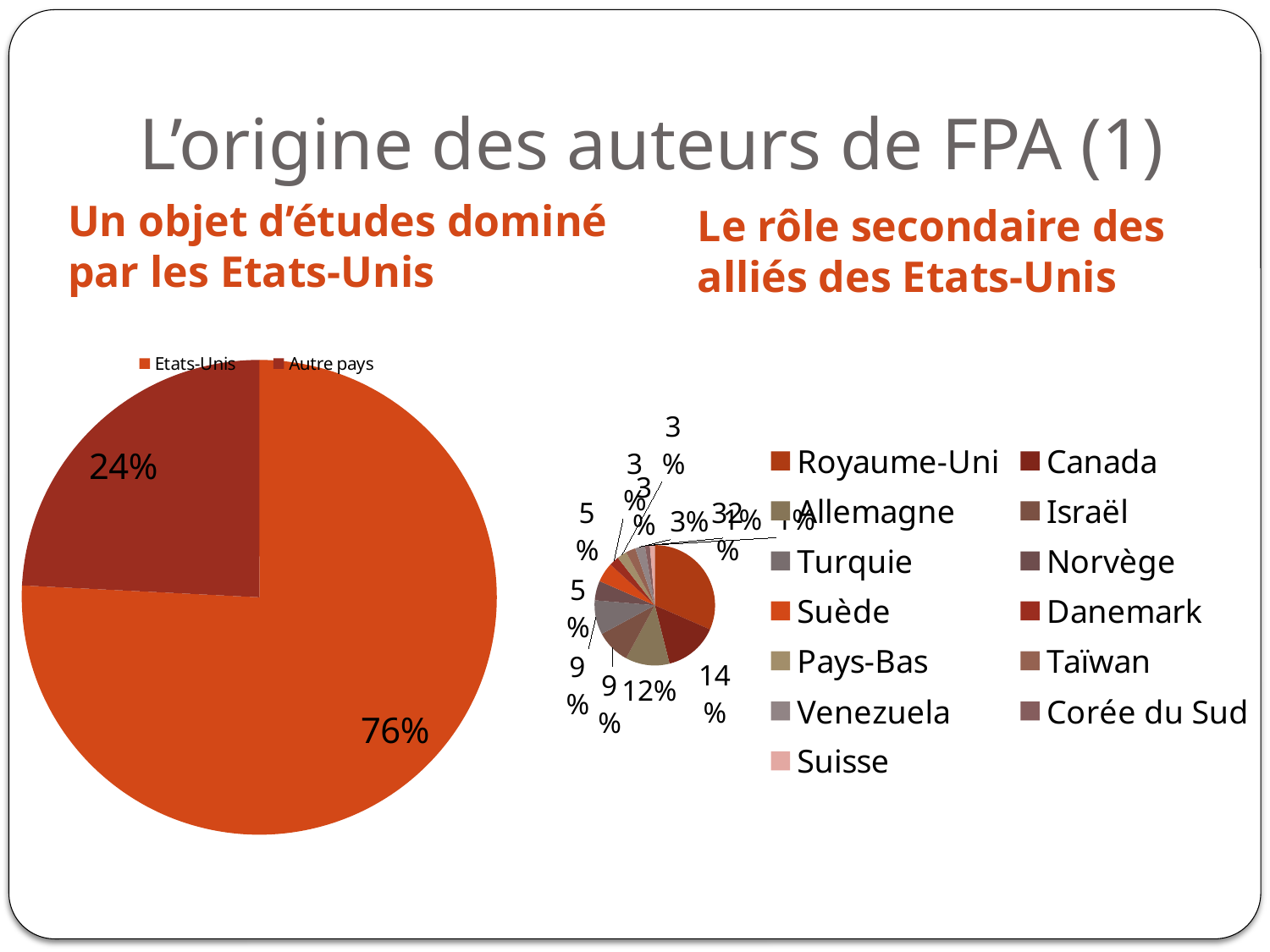
On the left pie chart, which is larger: Etats-Unis or Autre pays? Etats-Unis What kind of chart is the chart on the right of the slide? Pie chart On the left pie chart, which category has the smallest share? Autre pays On the left pie chart, which category has the largest share? Etats-Unis What are the two legend entries of the left pie chart? Etats-Unis and Autre pays How many categories does the left pie chart show? 2 On the left pie chart, what percentage is shown for Etats-Unis? 76% How many entries does the legend of the right pie chart list? 13 On the left pie chart, what percentage is shown for Autre pays? 24% What kind of chart is the chart on the left of the slide? Pie chart On the left pie chart, what is the difference between the Etats-Unis share and the Autre pays share? 52% On the right pie chart, which country has the largest slice? Royaume-Uni